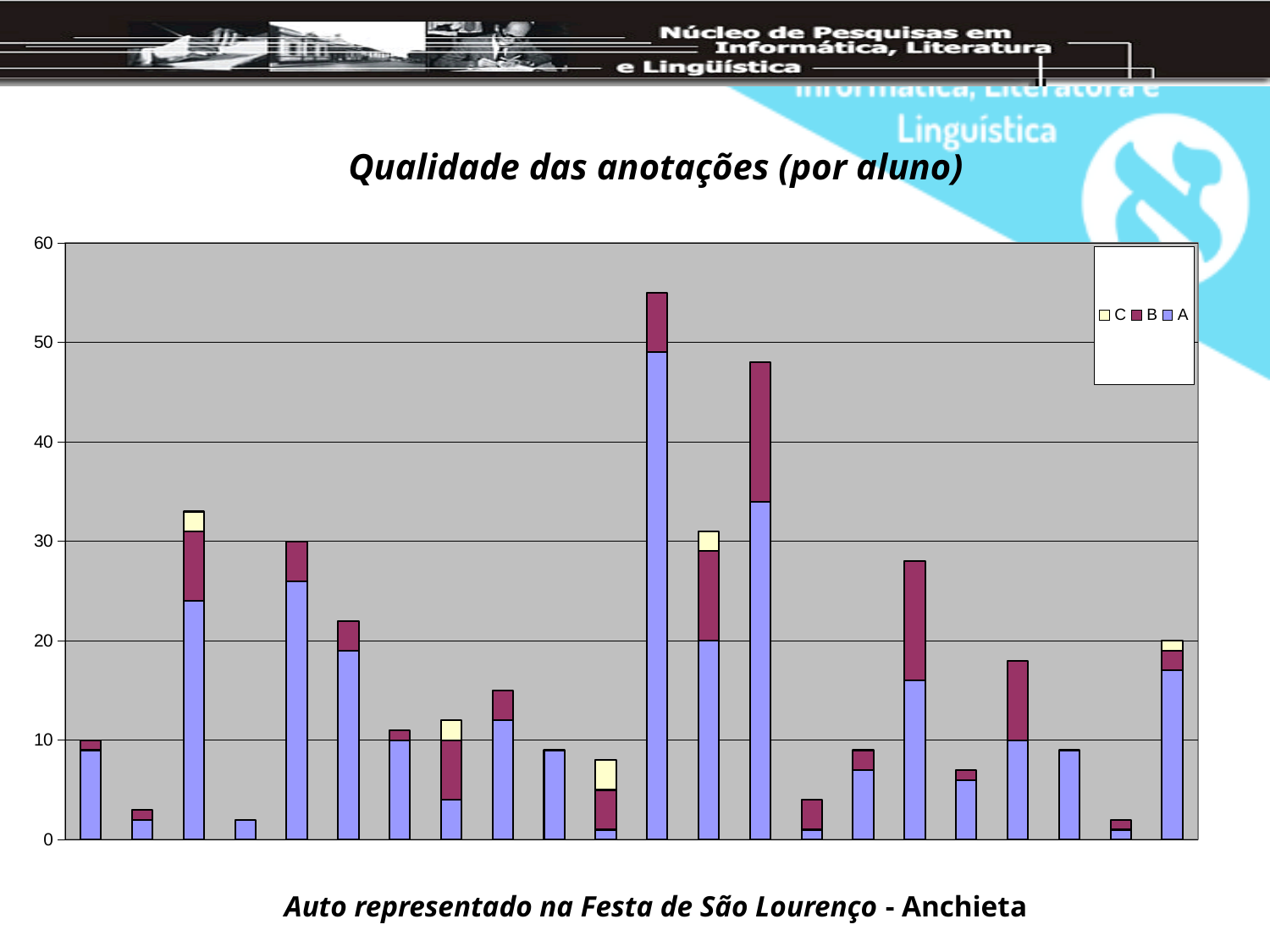
Is the total of the first bar from the left greater or less than 20? less Is the total of the last bar on the right greater or less than 30? less What are the series names listed in the legend? C, B, A How many series does the legend list? 3 How many stacked bars are plotted in the chart? 22 Is the total of the tallest stacked bar greater or less than 50? greater What is the title of the chart? Qualidade das anotações (por aluno) Which series makes up the largest portion of the tallest bar? A What is the highest value shown on the vertical axis? 60 What kind of chart is shown on the slide? bar chart